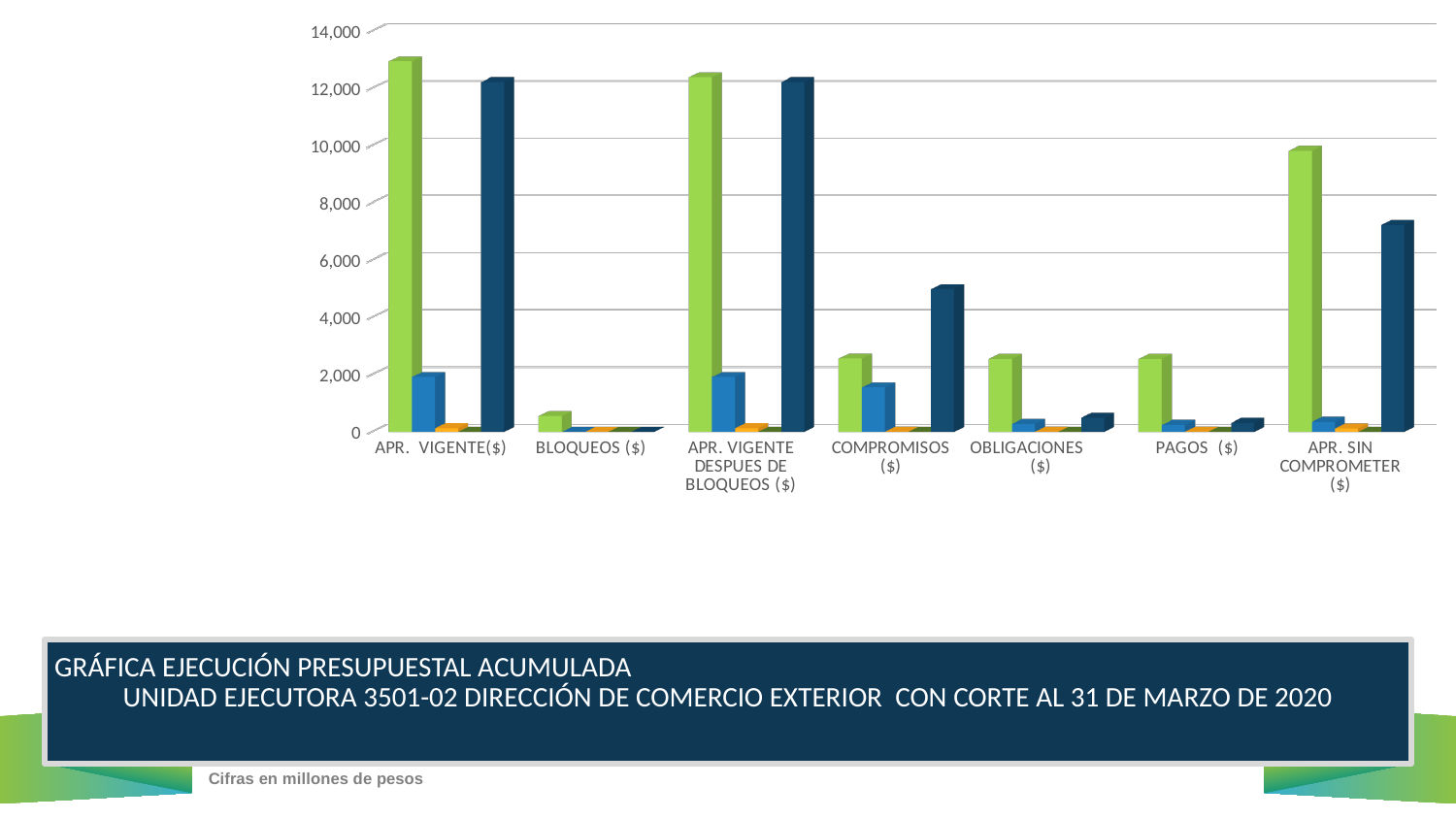
Is the light blue bar for APR. VIGENTE($) greater or less than 4,000? less Is the dark blue bar for COMPROMISOS ($) greater or less than 4,000? greater Is the green bar for APR. VIGENTE($) greater or less than 12,000? greater What kind of chart is shown on the slide? bar chart Which has the taller green bar, APR. SIN COMPROMETER ($) or PAGOS ($)? APR. SIN COMPROMETER ($) How many categories are shown along the x axis of the chart? 7 Which has the taller dark blue bar, COMPROMISOS ($) or OBLIGACIONES ($)? COMPROMISOS ($) What is the highest value shown on the y axis of the chart? 14,000 Which category has the shortest green bar? BLOQUEOS ($)